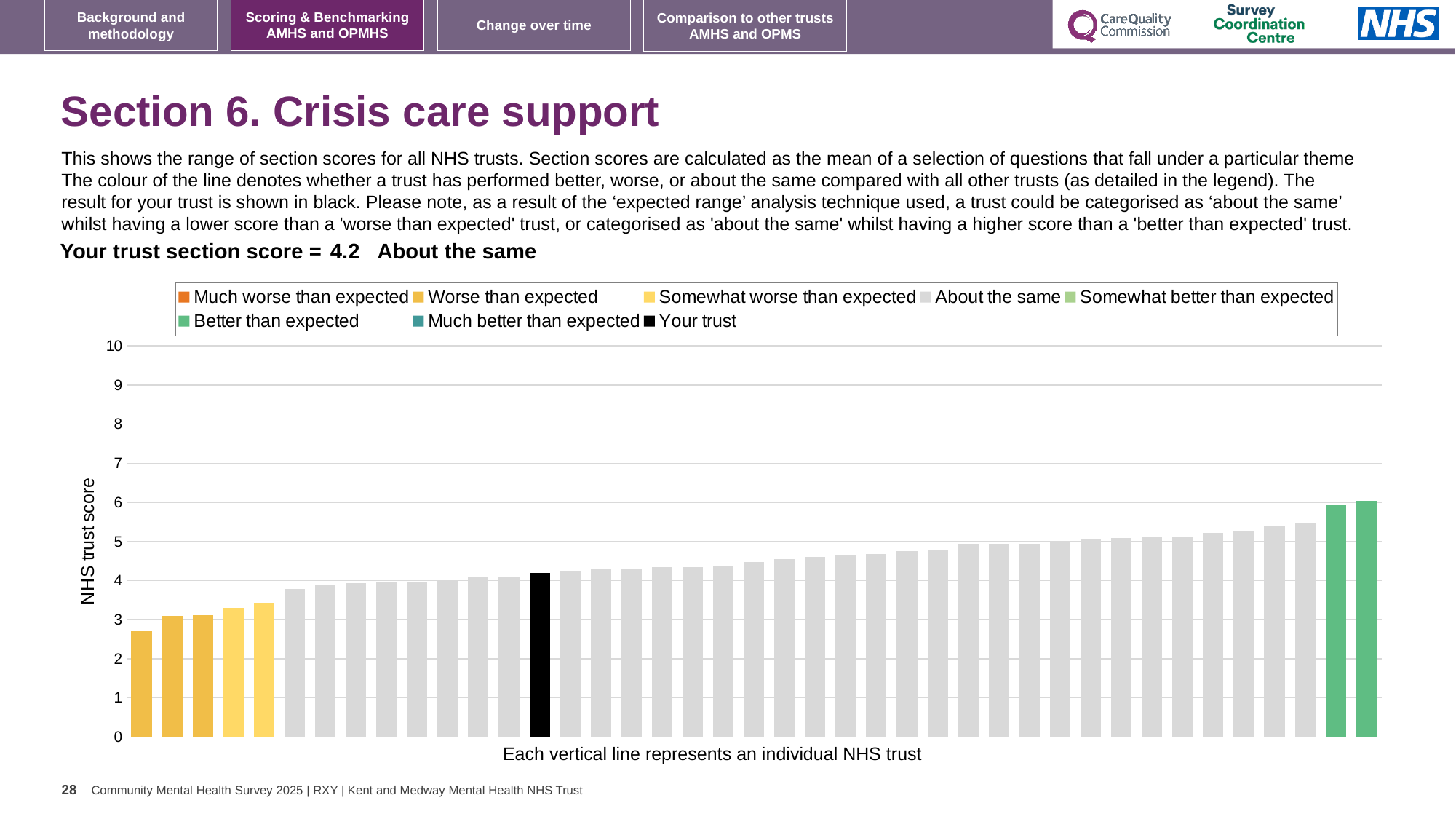
What is the label on the vertical axis of the chart? NHS trust score What is the highest value shown on the vertical axis? 10 Is the value of the tallest bar greater or less than 5? greater Is the value of the lowest bar greater or less than 3? less Which category is your trust placed in for this section? About the same How many entries does the chart legend list? 8 Is the value of the black bar (your trust) greater or less than 5? less What is the section score for your trust shown on the slide? 4.2 What colour is the bar representing your trust? black Do the bar values rise or fall from left to right across the chart? rise What kind of chart is shown on the slide? bar chart How many bars are coloured green (better than expected)? 2